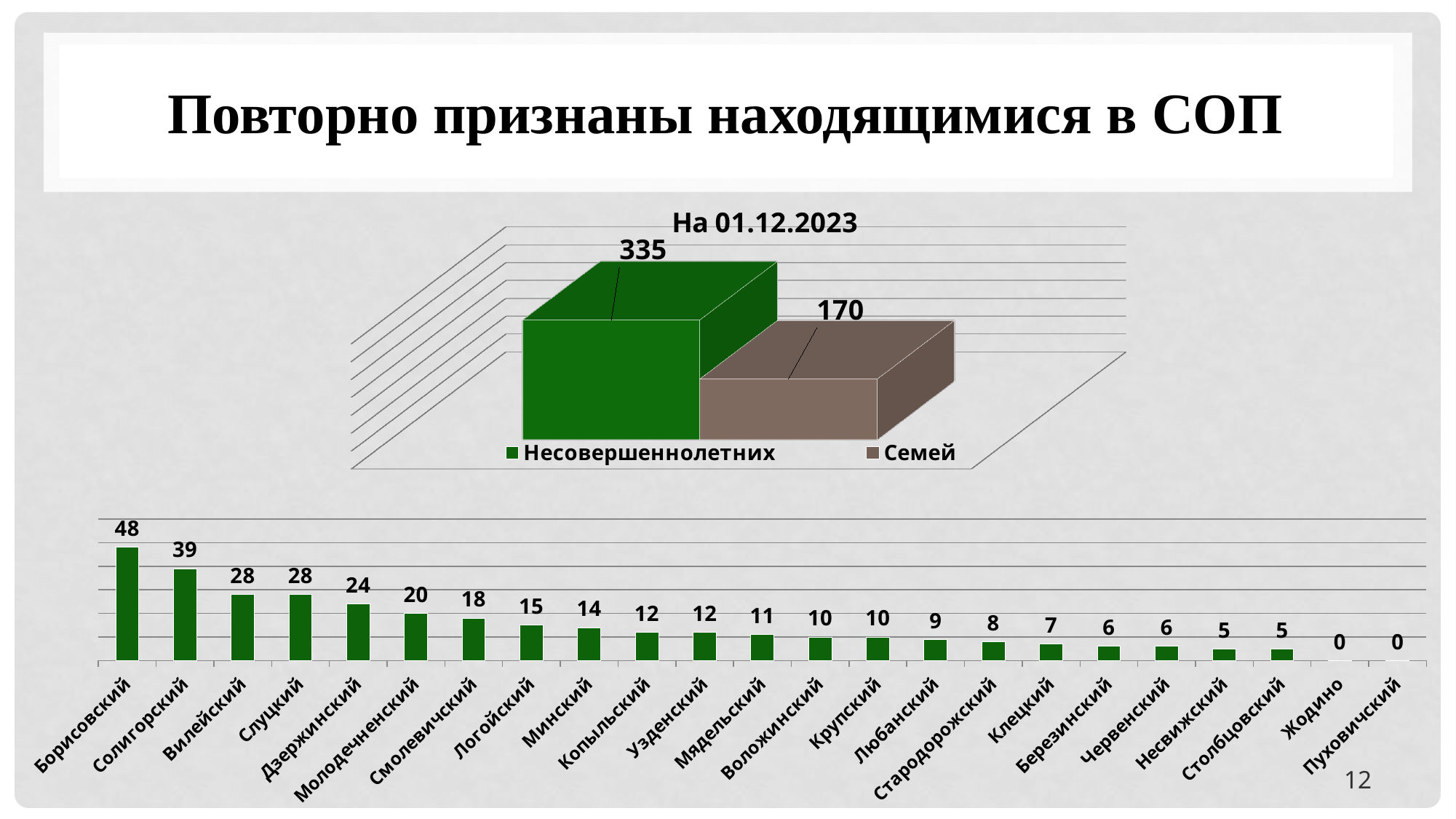
In the top chart titled 'На 01.12.2023', how many series does the legend list? 2 In the top chart titled 'На 01.12.2023', what is the difference between Несовершеннолетних and Семей? 165 In the bottom chart, what is the value for Молодечненский? 20 In the bottom chart, what is the value for Борисовский? 48 In the top chart titled 'На 01.12.2023', what is the value for Несовершеннолетних? 335 In the top chart titled 'На 01.12.2023', what is the value for Семей? 170 In the bottom chart, what is the value for Жодино? 0 In the bottom chart, what is the difference between Солигорский and Вилейский? 11 What kind of chart is the bottom chart? Bar chart In the bottom chart, how many districts are shown? 23 In the bottom chart, which is larger, Логойский or Минский? Логойский In the bottom chart, which district has the highest value? Борисовский